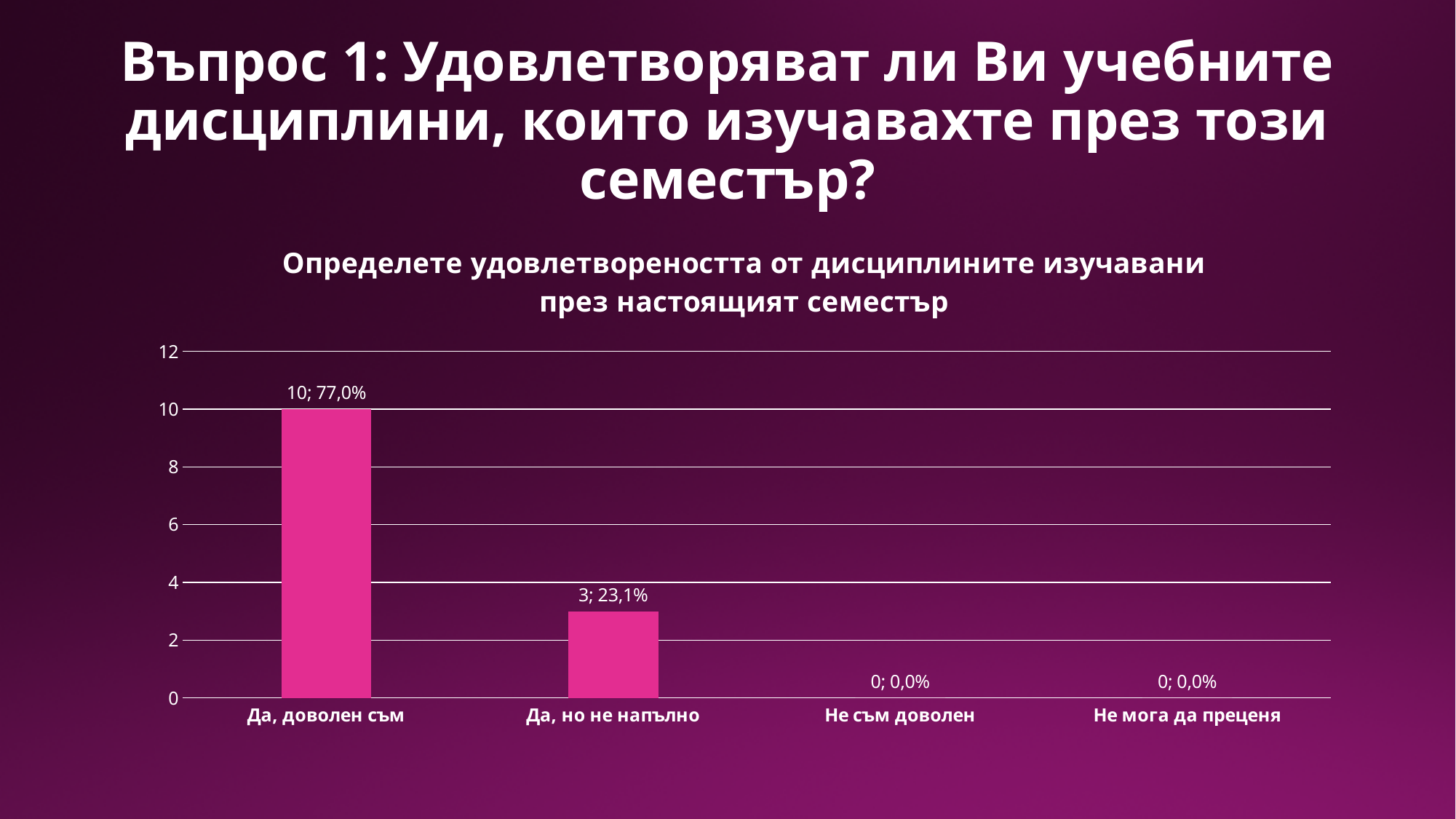
Which category has the highest value? Да, доволен съм What is the data label shown above the "Да, доволен съм" bar? 10; 77,0% Is the value for "Да, доволен съм" greater or less than 8? greater What is the highest value shown on the vertical axis? 12 Which is larger, the value for "Да, но не напълно" or the value for "Не мога да преценя"? Да, но не напълно How many categories are shown on the x axis? 4 What is the value for "Не съм доволен"? 0 What is the value for "Да, доволен съм"? 10 What percentage is shown for "Да, но не напълно"? 23,1% What kind of chart is shown on the slide? bar chart What is the difference between the values for "Да, доволен съм" and "Да, но не напълно"? 7 Do the values rise or fall from left to right along the x axis? fall